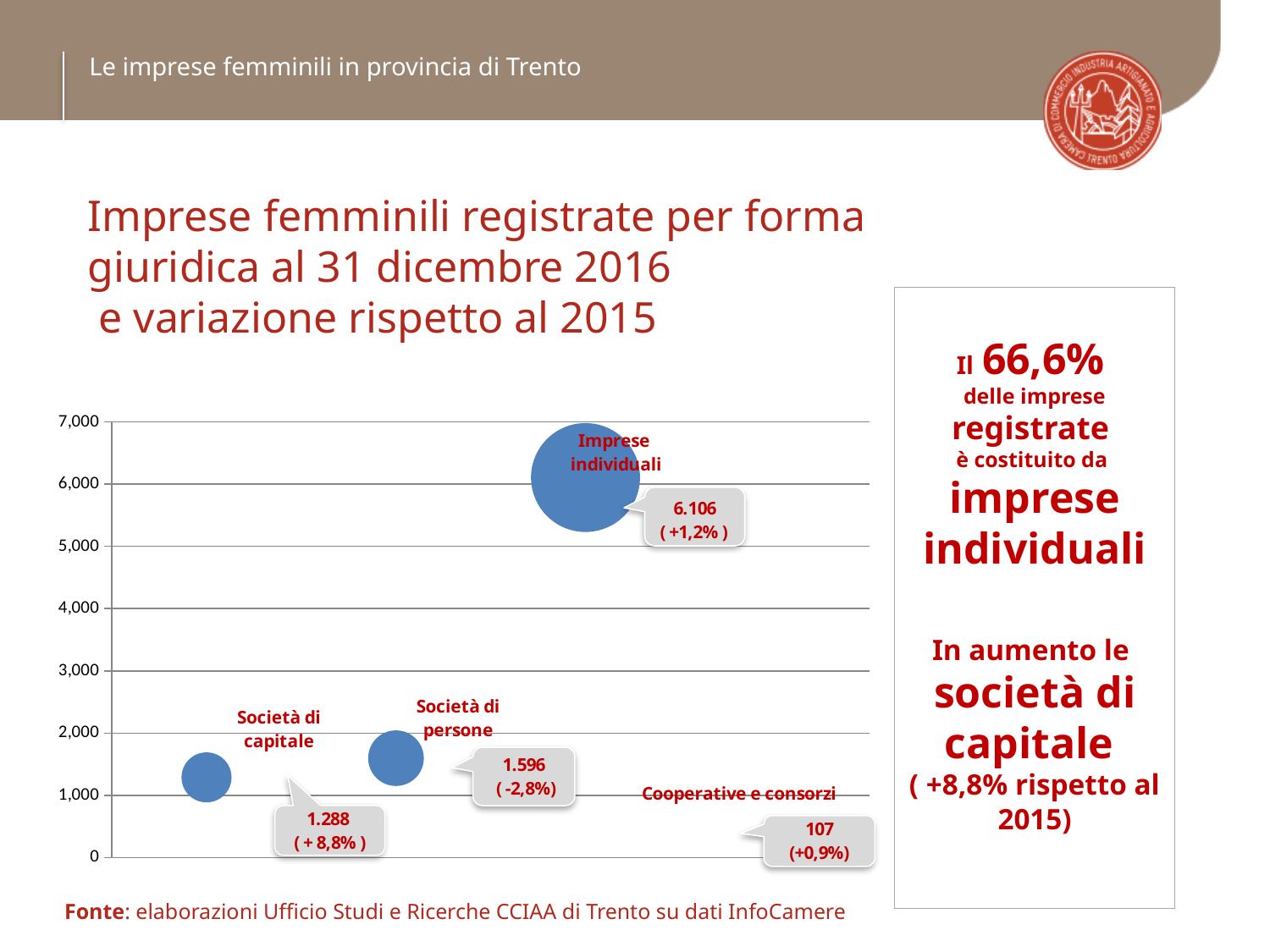
How many legal forms (categories) are plotted on the chart? 4 Which legal form has the lowest number of registered female enterprises? Cooperative e consorzi What is the value shown for Imprese individuali? 6.106 What is the value shown for Società di persone? 1.596 What percentage change compared to 2015 is shown for Società di capitale? +8,8% Which is larger, the value for Società di persone or the value for Società di capitale? Società di persone Which legal form has the highest number of registered female enterprises? Imprese individuali What is the value shown for Società di capitale? 1.288 What is the value shown for Cooperative e consorzi? 107 What kind of chart is shown on the slide? Bubble chart What percentage change compared to 2015 is shown for Società di persone? -2,8% What is the difference between the values for Imprese individuali and Società di persone? 4.510